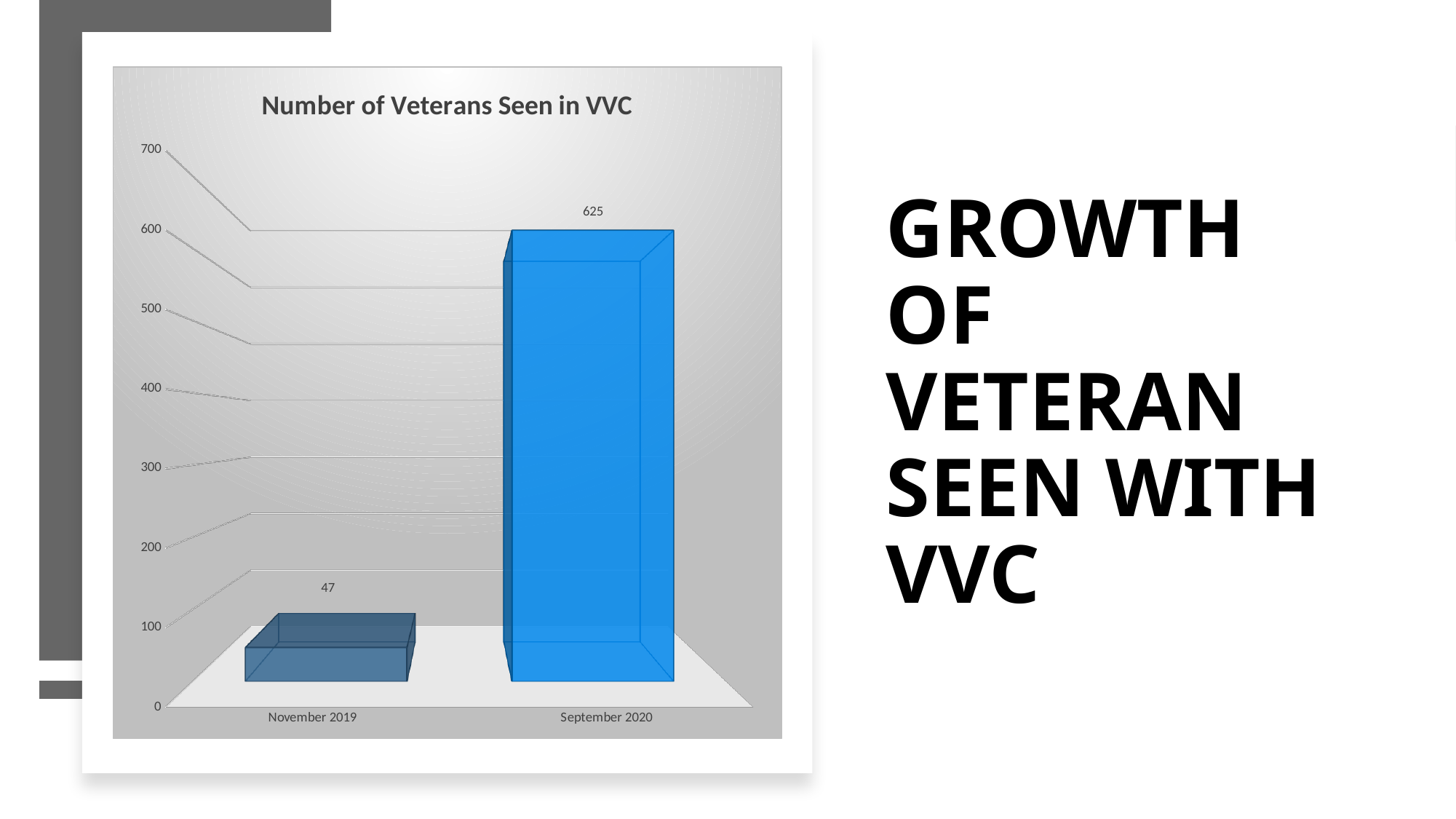
What is the value for September 2020? 625 What is the title of the chart? Number of Veterans Seen in VVC Is the value for September 2020 greater or less than 600? greater What is the difference between the values for September 2020 and November 2019? 578 Which category has the lowest value? November 2019 How many categories are shown on the x axis? 2 What kind of chart is shown? bar chart What is the value for November 2019? 47 Do the values rise or fall from November 2019 to September 2020? rise Is the value for November 2019 greater or less than 100? less Which is larger, the value for November 2019 or the value for September 2020? September 2020 Which category has the highest value? September 2020